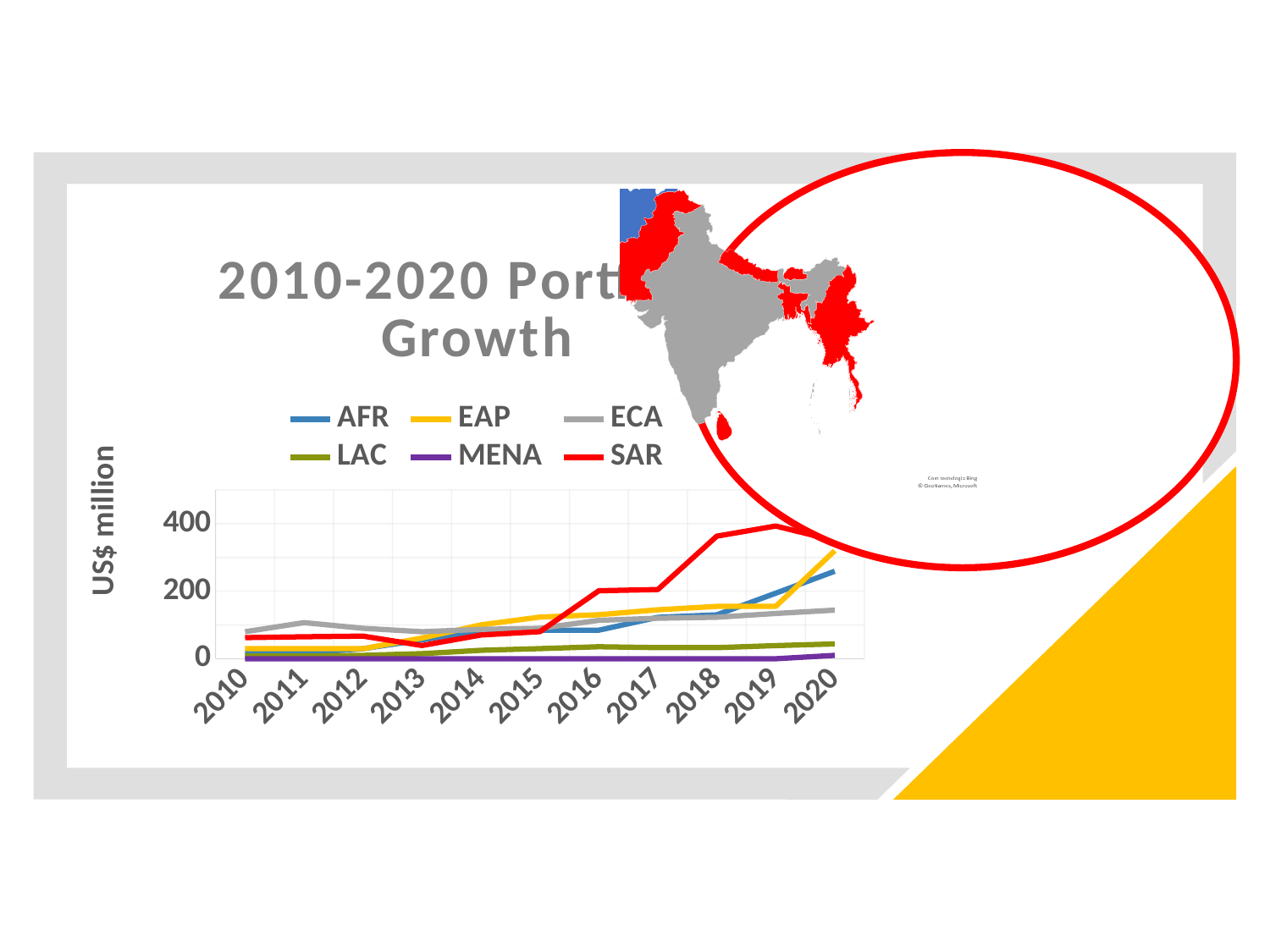
Does the SAR series generally rise or fall from 2010 to 2020? rise Which series is shown in red in the legend? SAR How many series does the legend list? 6 How many years are shown along the x axis? 11 What kind of chart is shown on the slide? line chart Which series has the lowest value in 2020? MENA Which is larger in 2020, the value for EAP or the value for AFR? EAP Is the value for ECA in 2020 greater or less than 200? less Is the value for SAR in 2019 greater or less than 200? greater What is the label on the vertical axis? US$ million Which series has the highest value in 2019? SAR Is the value for MENA in 2015 greater or less than 200? less